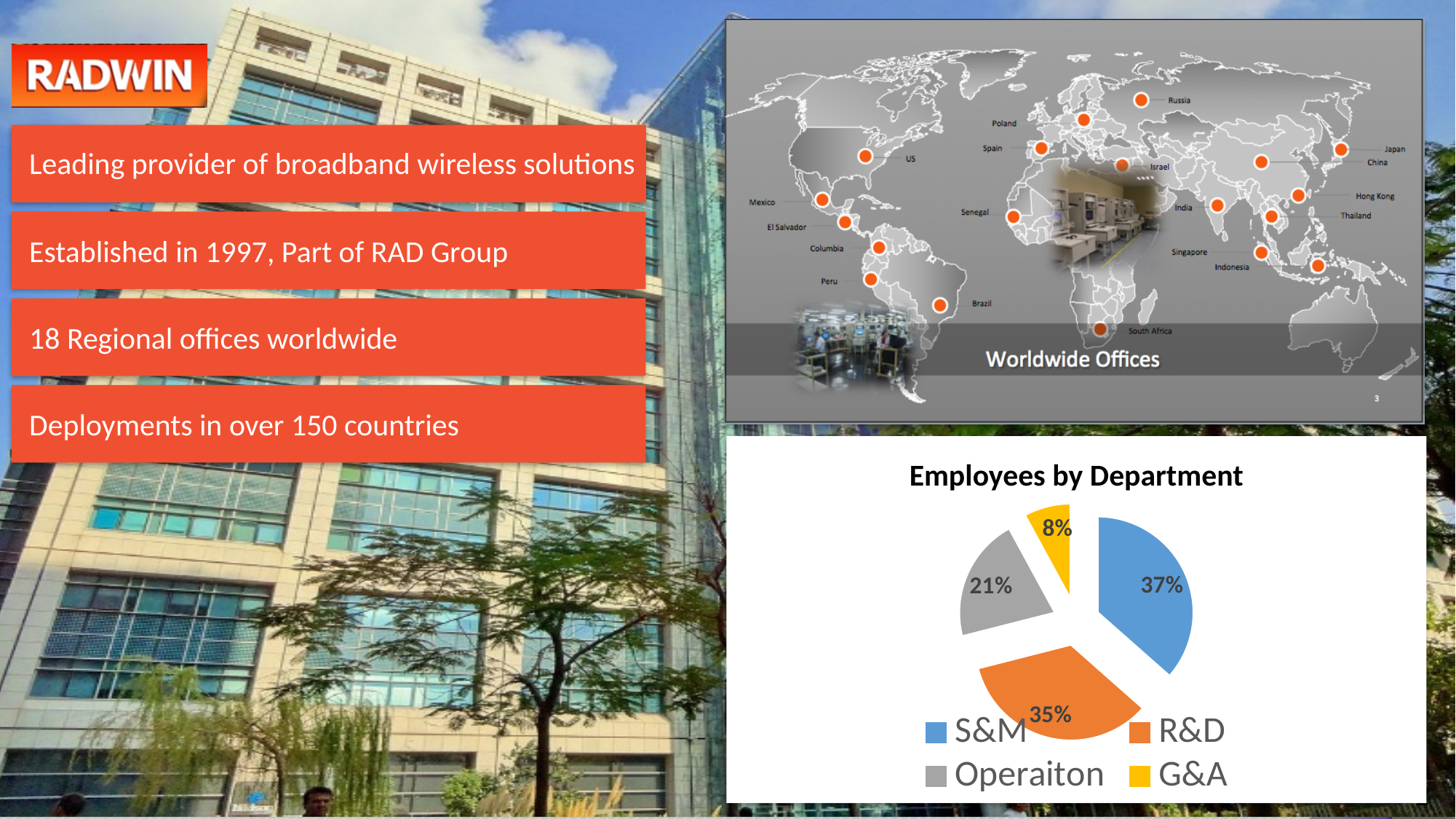
Which department has the largest share of employees? S&M What share of employees is in Operaiton? 21% What share of employees is in S&M? 37% What is the title of the chart on the slide? Employees by Department What share of employees is in R&D? 35% What share of employees is in G&A? 8% Which department has the smallest share of employees? G&A Which colour represents R&D in the pie chart? orange What is the difference in percentage points between the S&M and R&D shares? 2 How many departments are shown in the pie chart? 4 What kind of chart is "Employees by Department"? pie chart What is the difference in percentage points between the Operaiton and G&A shares? 13